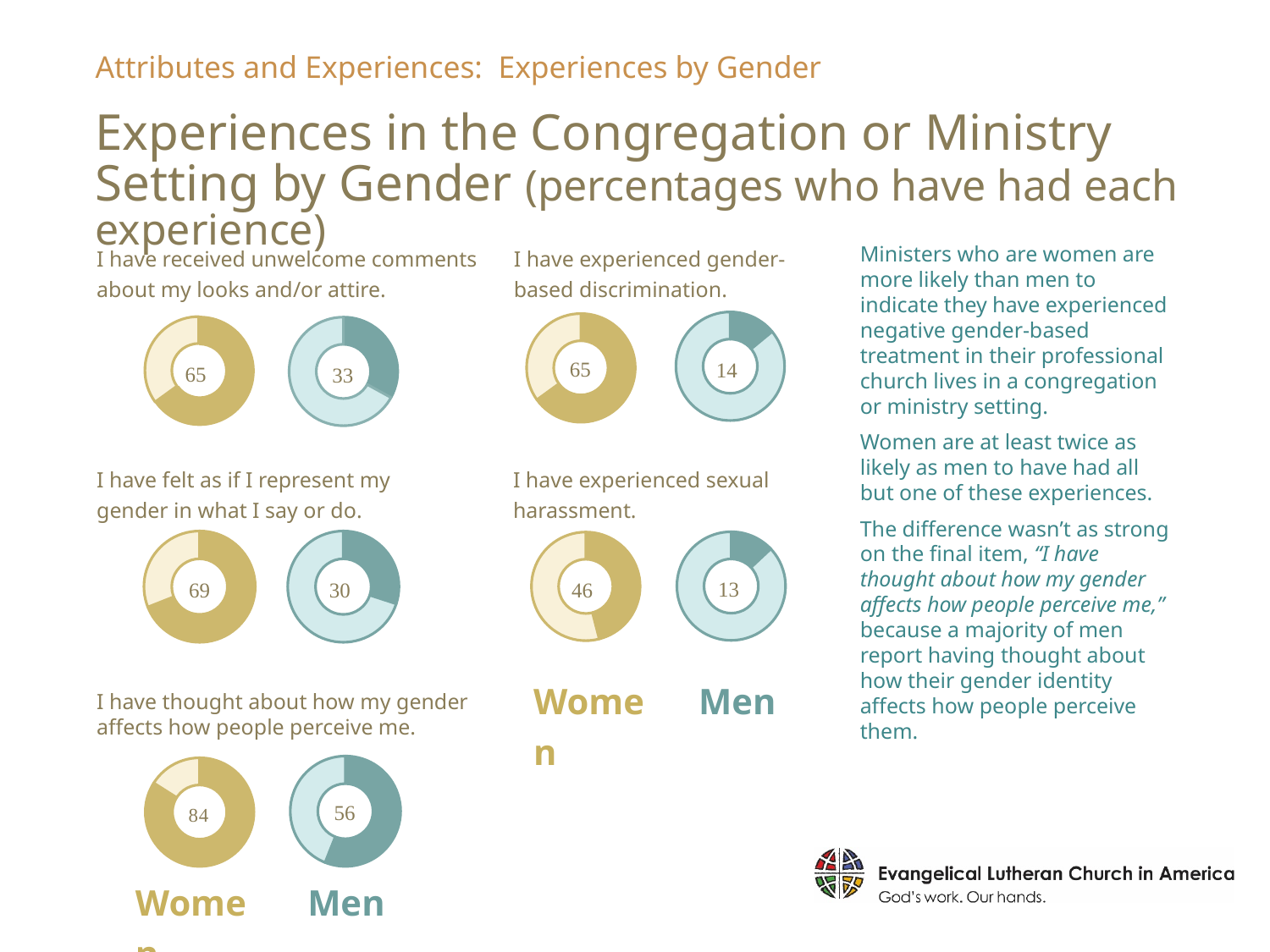
In the chart for "I have thought about how my gender affects how people perceive me," what value is shown for men? 56 In the chart for "I have felt as if I represent my gender in what I say or do," what value is shown for women? 69 In the chart for "I have experienced sexual harassment," what value is shown for men? 13 Across all the charts on the slide, which experience has the highest value for women? I have thought about how my gender affects how people perceive me In the chart for "I have experienced gender-based discrimination," what is the difference between the women's and men's values? 51 In the chart for "I have received unwelcome comments about my looks and/or attire," what percentage of men have had this experience? 33 In the chart for "I have thought about how my gender affects how people perceive me," what is the difference between the women's and men's values? 28 What kind of chart is used to show the percentages on this slide? Donut chart In the chart for "I have experienced sexual harassment," which group has the larger value, women or men? Women In the chart for "I have received unwelcome comments about my looks and/or attire," what percentage of women have had this experience? 65 In the chart for "I have experienced gender-based discrimination," what value is shown for men? 14 Across all the charts on the slide, which experience has the lowest value for men? I have experienced sexual harassment